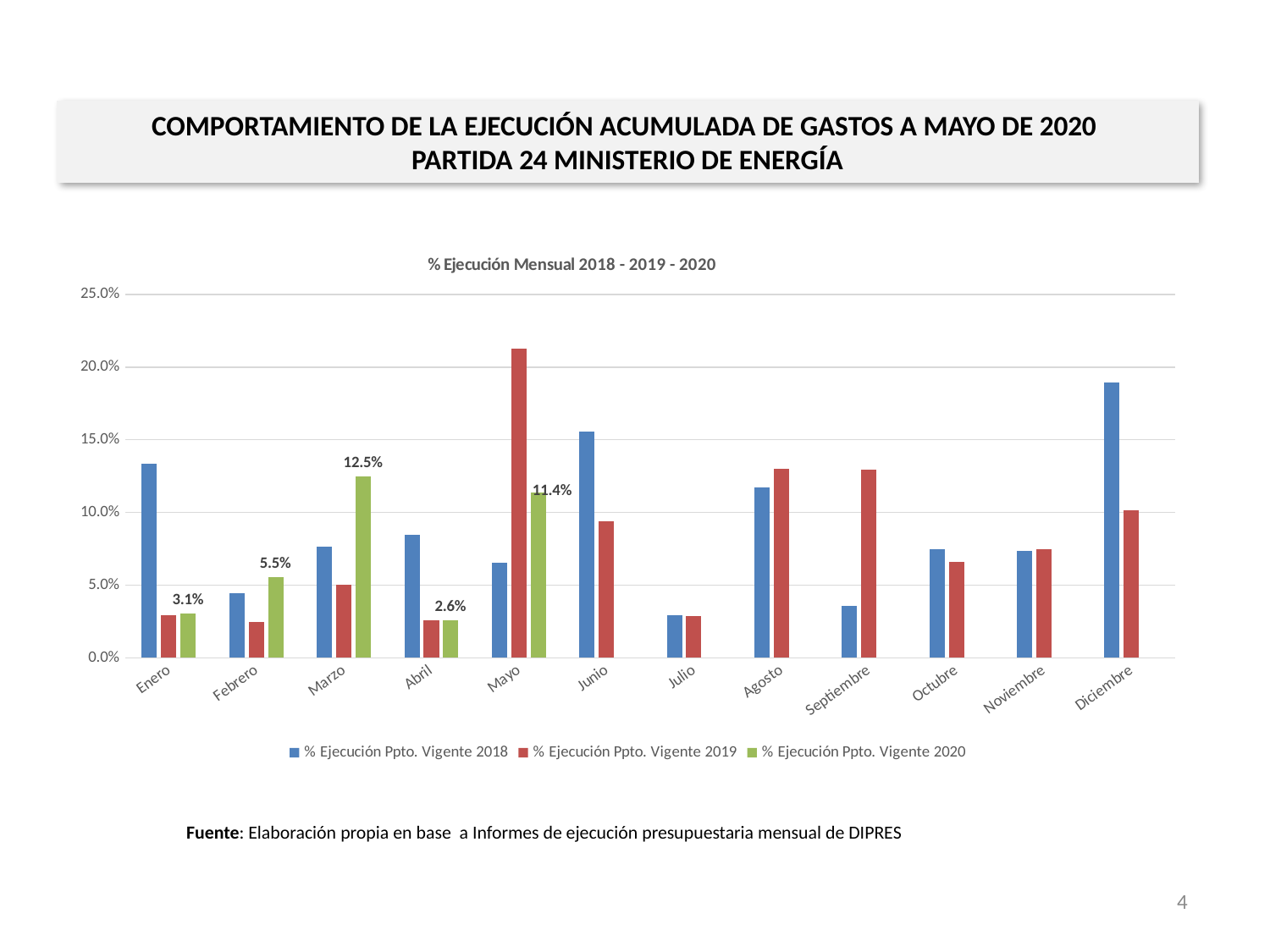
Is the value for Mayo in the % Ejecución Ppto. Vigente 2019 series greater or less than 20.0%? greater In the % Ejecución Ppto. Vigente 2020 series, which is larger: Mayo or Febrero? Mayo What is the value for Marzo in the % Ejecución Ppto. Vigente 2020 series? 12.5% How many months are shown on the x axis of the chart? 12 Which month has the highest value in the % Ejecución Ppto. Vigente 2020 series? Marzo What is the value for Enero in the % Ejecución Ppto. Vigente 2020 series? 3.1% How many series does the legend list? 3 Is the value for Diciembre in the % Ejecución Ppto. Vigente 2018 series greater or less than 15.0%? greater What is the difference between the Marzo and Febrero values in the % Ejecución Ppto. Vigente 2020 series? 7.0% What is the title of the chart? % Ejecución Mensual 2018 - 2019 - 2020 Which month has the lowest value in the % Ejecución Ppto. Vigente 2020 series? Abril What kind of chart is shown on the slide? bar chart